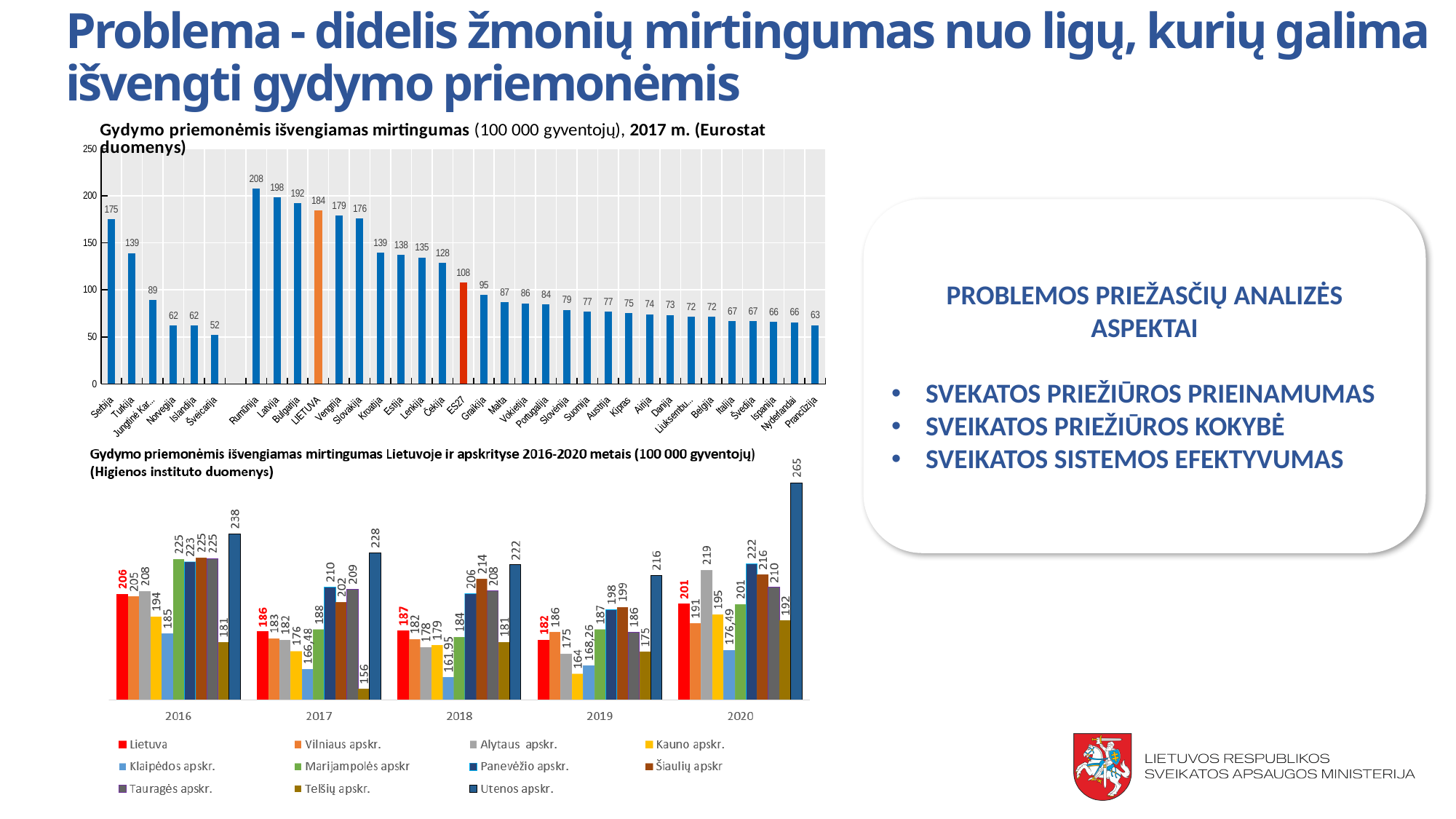
In the top chart (2017 Eurostat data), what is the value for ES27? 108 In the top chart (2017 Eurostat data), which is larger, the value for Latvija or for Bulgarija? Latvija In the bottom chart (Lietuvoje ir apskrityse 2016-2020), how many series does the legend list? 11 In the bottom chart (Lietuvoje ir apskrityse 2016-2020), what is the value for Lietuva in 2020? 201 In the top chart (2017 Eurostat data), what is the difference between the values for LIETUVA and ES27? 76 In the top chart (2017 Eurostat data), what is the value for LIETUVA? 184 In the top chart (2017 Eurostat data), which country has the highest value? Rumūnija What kind of chart is the top chart (2017 Eurostat data)? Bar chart In the bottom chart (Lietuvoje ir apskrityse 2016-2020), how many years are shown on the x axis? 5 In the bottom chart (Lietuvoje ir apskrityse 2016-2020), what is the value for Klaipėdos apskr. in 2017? 166,48 In the bottom chart (Lietuvoje ir apskrityse 2016-2020), what is the value for Utenos apskr. in 2020? 265 In the top chart (2017 Eurostat data), which country has the lowest value? Šveicarija